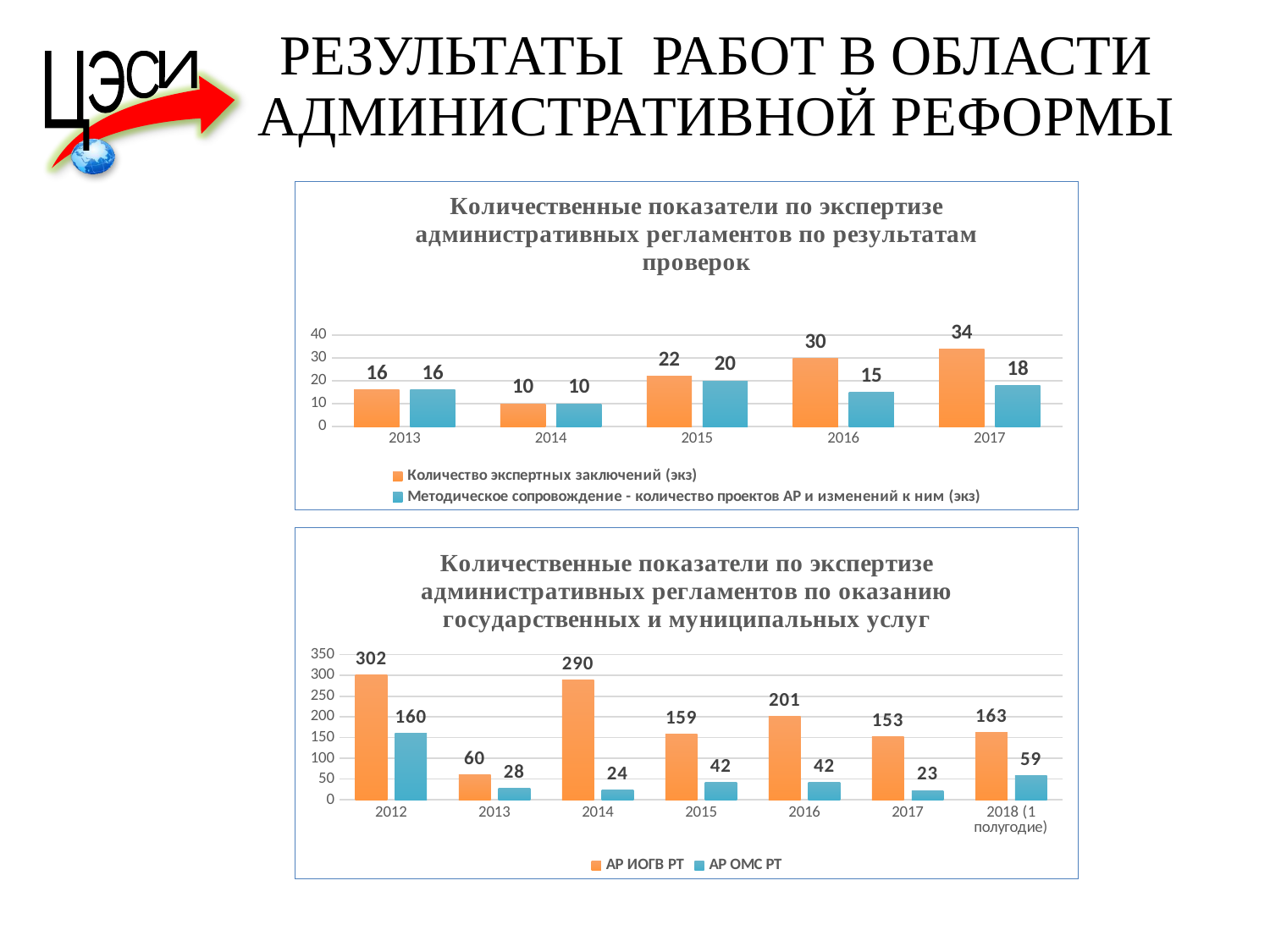
In the bottom chart (по оказанию государственных и муниципальных услуг), which year has the highest value for АР ИОГВ РТ? 2012 In the bottom chart (по оказанию государственных и муниципальных услуг), which is larger in 2013: АР ИОГВ РТ or АР ОМС РТ? АР ИОГВ РТ In the top chart (по результатам проверок), what is the value of Количество экспертных заключений (экз) for 2017? 34 What type of chart is the bottom chart (по оказанию государственных и муниципальных услуг)? Bar chart In the top chart (по результатам проверок), what is the difference between Количество экспертных заключений and Методическое сопровождение in 2016? 15 In the bottom chart (по оказанию государственных и муниципальных услуг), what is the value of АР ОМС РТ for 2018 (1 полугодие)? 59 In the top chart (по результатам проверок), which year has the lowest value for Методическое сопровождение? 2014 In the top chart (по результатам проверок), what is the value of Методическое сопровождение for 2015? 20 In the bottom chart (по оказанию государственных и муниципальных услуг), what is the difference between АР ИОГВ РТ and АР ОМС РТ in 2012? 142 In the top chart (по результатам проверок), which year has the highest value for Количество экспертных заключений (экз)? 2017 In the bottom chart (по оказанию государственных и муниципальных услуг), what is the value of АР ИОГВ РТ for 2014? 290 In the top chart (по результатам проверок), how many years are shown on the x axis? 5